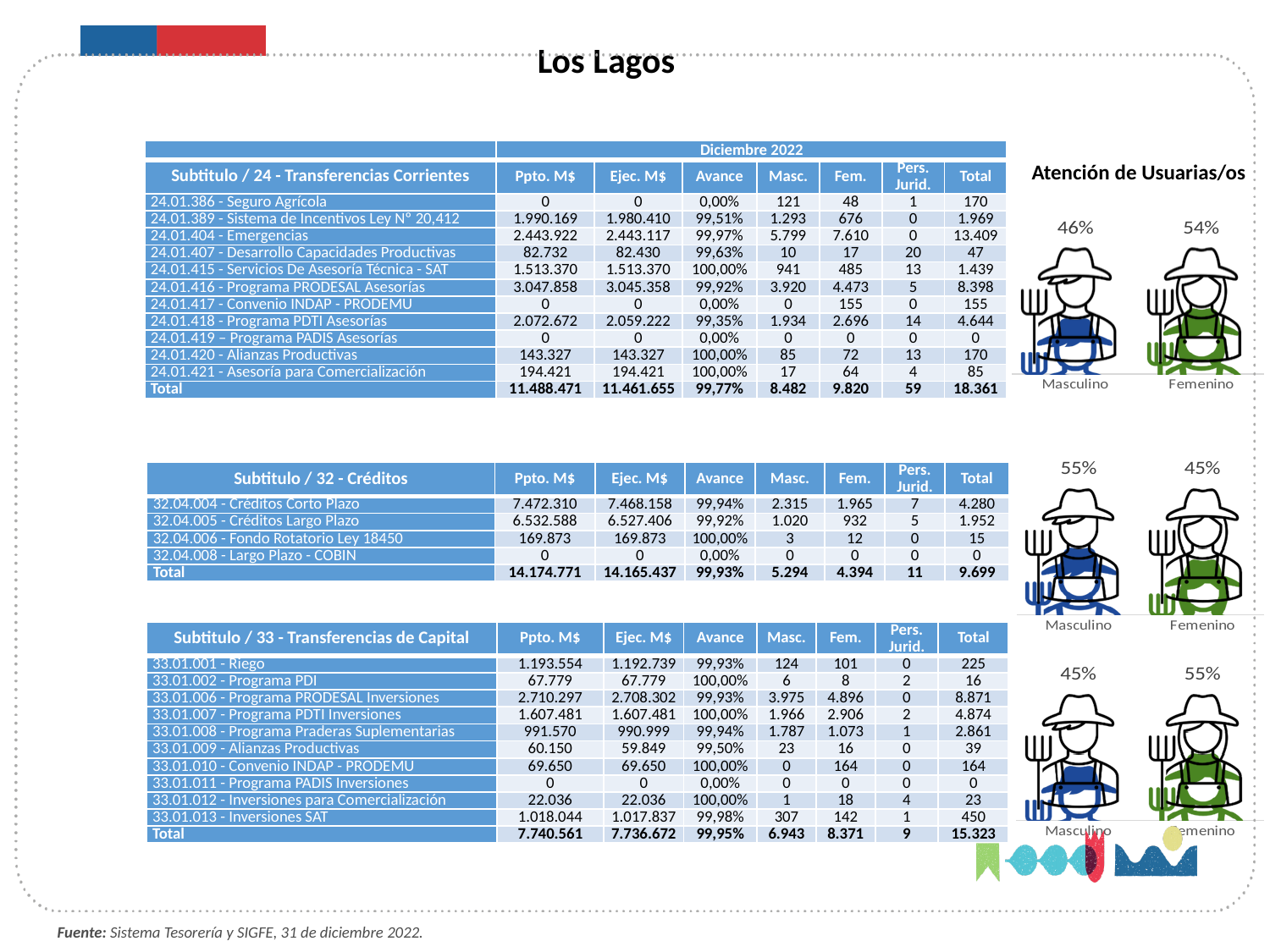
In the top 'Atención de Usuarias/os' pictogram chart (next to Subtítulo 24), which category has the higher share, Masculino or Femenino? Femenino In the bottom pictogram chart (next to Subtítulo 33 - Transferencias de Capital), what percentage is shown for Masculino? 45% In the top 'Atención de Usuarias/os' pictogram chart (next to Subtítulo 24), what percentage is shown for Femenino? 54% In the middle pictogram chart (next to Subtítulo 32 - Créditos), what percentage is shown for Masculino? 55% In the top 'Atención de Usuarias/os' pictogram chart (next to Subtítulo 24), what percentage is shown for Masculino? 46% In the bottom pictogram chart (next to Subtítulo 33 - Transferencias de Capital), what percentage is shown for Femenino? 55% How many categories does each pictogram chart on the right side of the slide show? 2 In the top 'Atención de Usuarias/os' pictogram chart (next to Subtítulo 24), what is the difference between the Femenino and Masculino percentages? 8% In the bottom pictogram chart (next to Subtítulo 33 - Transferencias de Capital), what is the difference between the Femenino and Masculino percentages? 10% In the middle pictogram chart (next to Subtítulo 32 - Créditos), what percentage is shown for Femenino? 45% In the middle pictogram chart (next to Subtítulo 32 - Créditos), which category is larger, Masculino or Femenino? Masculino What is the title shown above the top pictogram chart on the right side of the slide? Atención de Usuarias/os